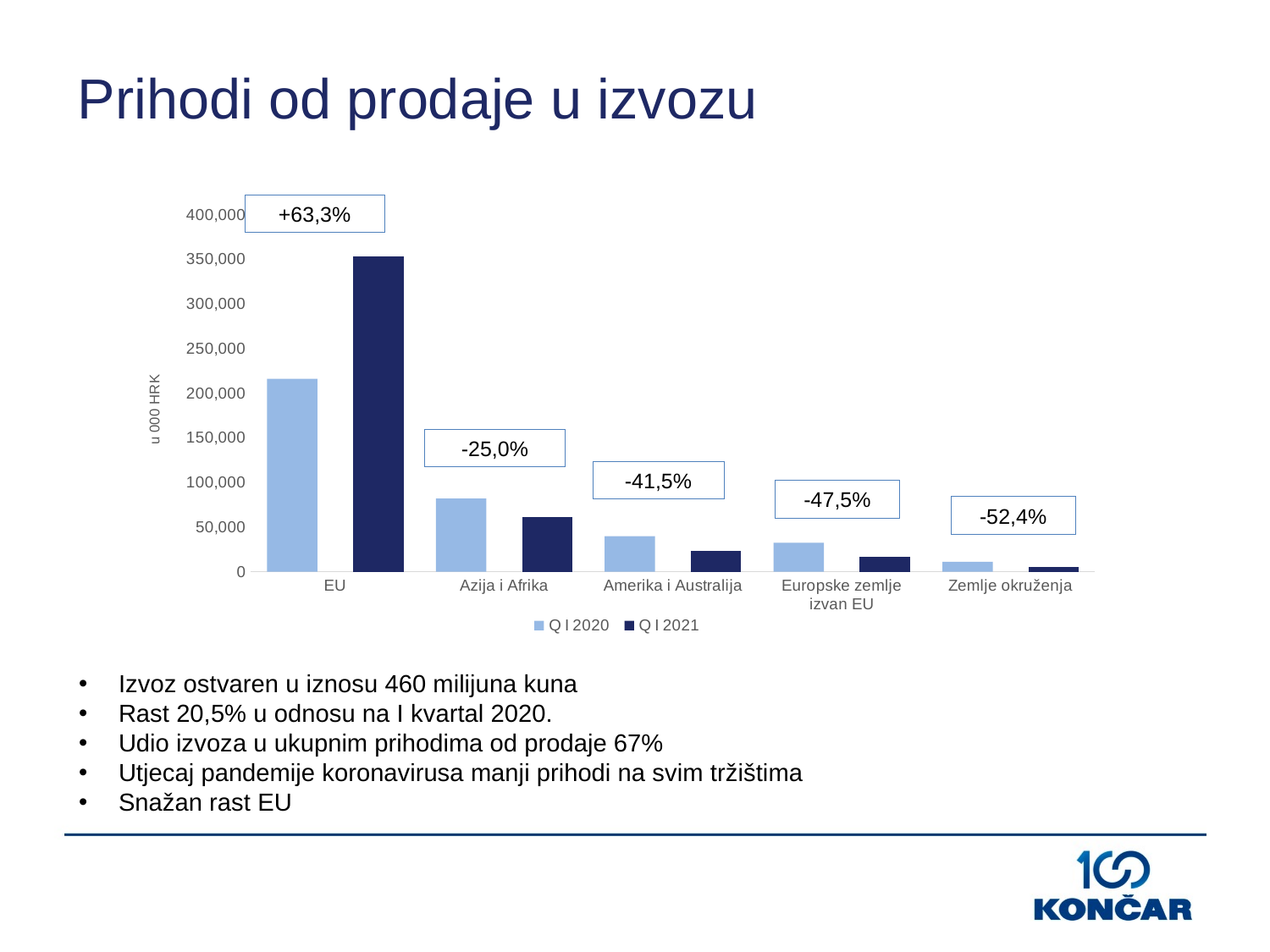
Is the Q I 2020 value for EU greater or less than 200,000? greater What percentage change is printed above the Zemlje okruženja bars? -52,4% What percentage change is printed above the Azija i Afrika bars? -25,0% What percentage change is printed above the EU bars? +63,3% What unit is shown on the y axis of the chart? u 000 HRK For EU, which is larger: the Q I 2020 bar or the Q I 2021 bar? Q I 2021 Which category has the tallest bar in the chart? EU How many series does the chart legend list? 2 What kind of chart is shown on the slide? bar chart How many categories are shown on the x axis of the chart? 5 What percentage change is printed above the Europske zemlje izvan EU bars? -47,5% Which category has the lowest Q I 2021 bar? Zemlje okruženja